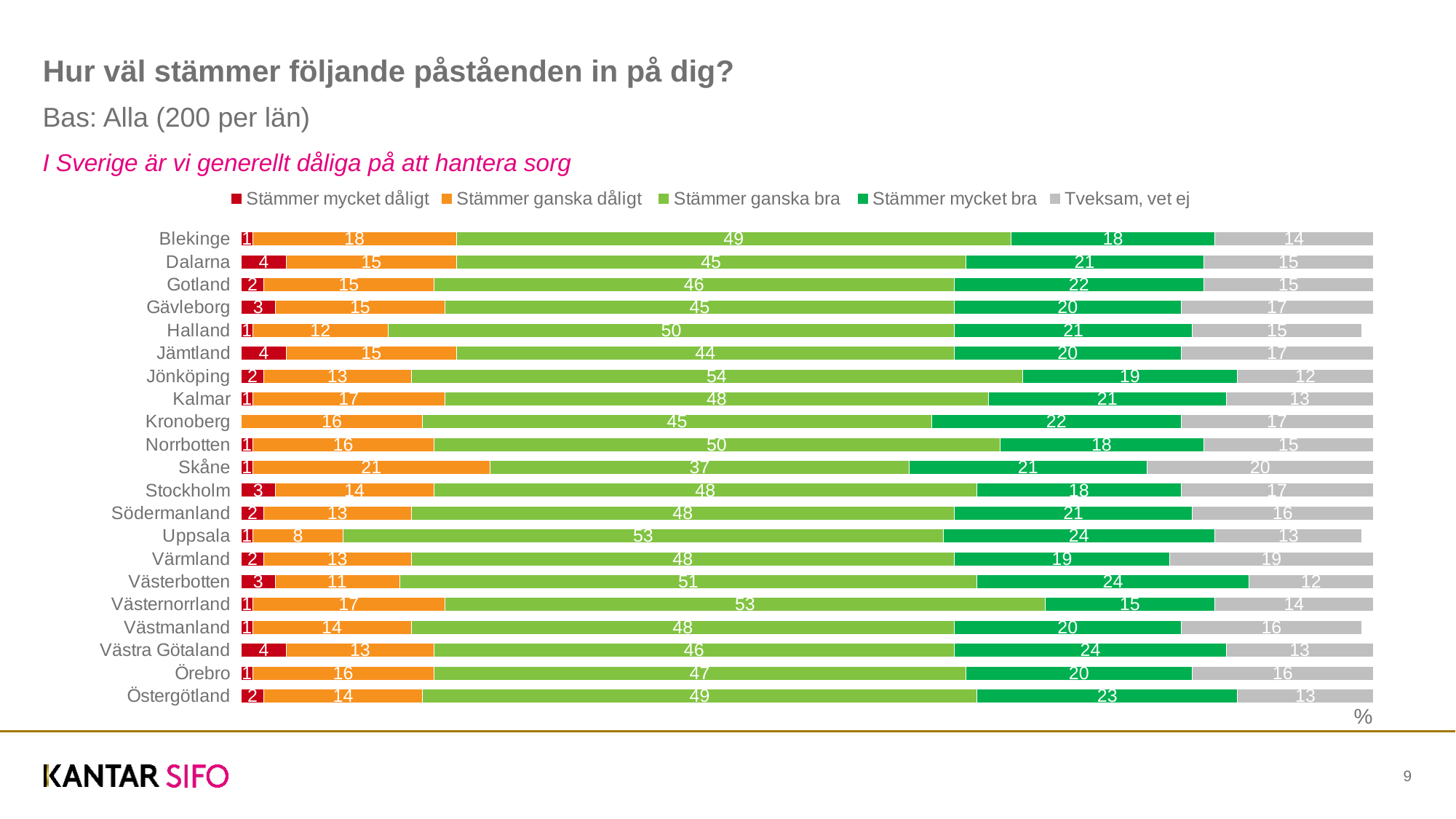
What is the value for "Tveksam, vet ej" in Skåne? 20 What is the difference between the "Stämmer ganska bra" values for Jönköping and Skåne? 17 How many series does the legend list? 5 What percentage of respondents in Jönköping answered "Stämmer ganska bra"? 54 Which county has the lowest value for "Stämmer ganska bra"? Skåne Which county has the highest value for "Stämmer ganska bra"? Jönköping Which county has the highest value for "Stämmer ganska dåligt"? Skåne How many counties are shown in the chart? 21 Which is larger: the "Stämmer mycket bra" value for Gotland or for Stockholm? Gotland What is the value for "Stämmer ganska dåligt" in Uppsala? 8 What is the value for "Stämmer mycket bra" in Västernorrland? 15 What kind of chart is shown on the slide? Stacked bar chart